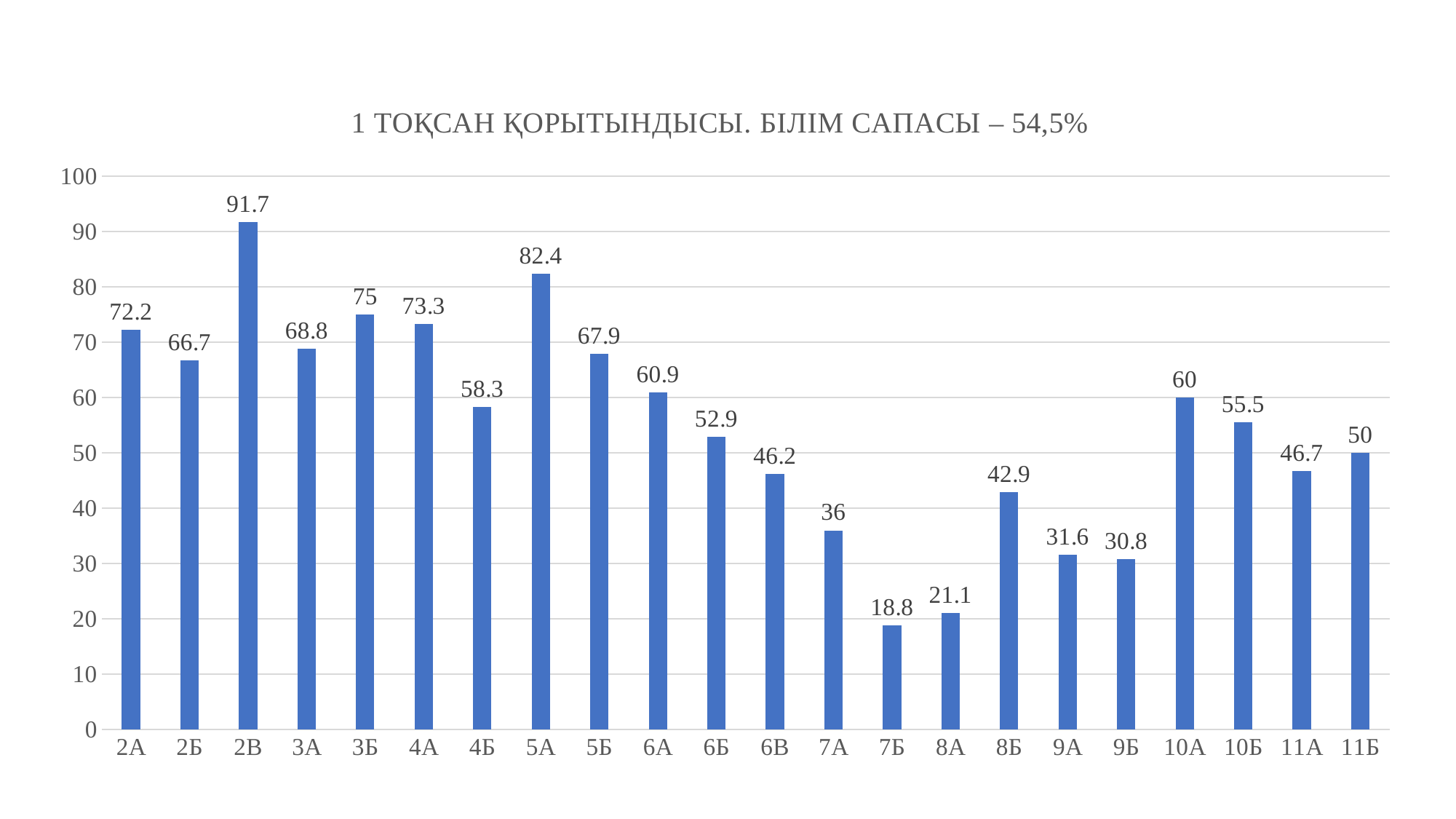
Is the value for 8Б greater or less than 40? greater What is the value for 10А? 60 How many categories are shown on the x axis? 22 What is the value for 7Б? 18.8 What is the value for 11Б? 50 Which category has the lowest value? 7Б What kind of chart is this? bar chart What is the title of the chart? 1 ТОҚСАН ҚОРЫТЫНДЫСЫ. БІЛІМ САПАСЫ – 54,5% Which category has the highest value? 2В What is the value for 2В? 91.7 What is the difference between the values for 5А and 5Б? 14.5 Which is larger, the value for 3Б or the value for 4А? 3Б